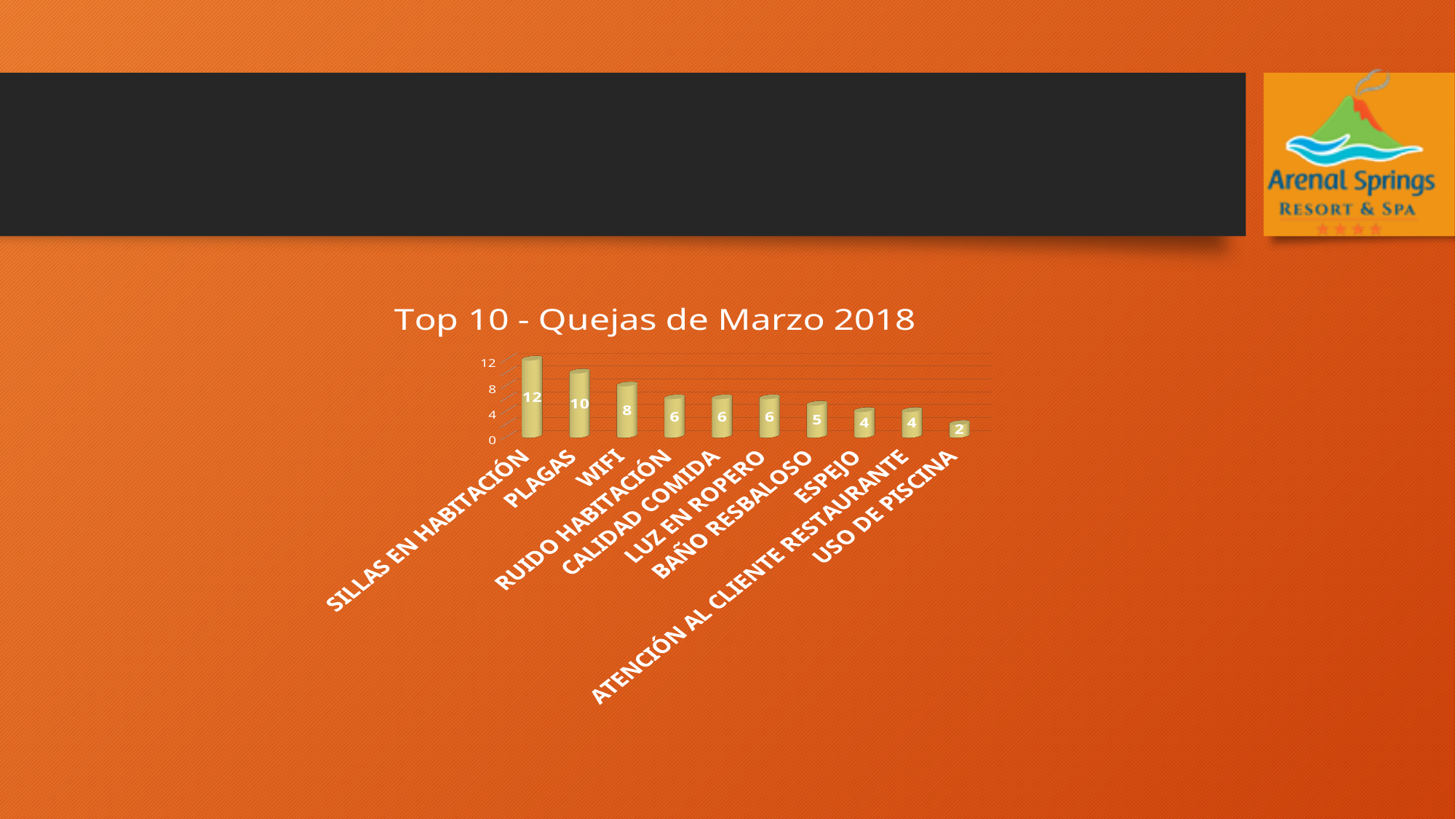
Which category has the highest value? SILLAS EN HABITACIÓN Do the values rise or fall from left to right along the x axis? Fall What is the value for SILLAS EN HABITACIÓN? 12 Which is larger, the value for BAÑO RESBALOSO or the value for ESPEJO? BAÑO RESBALOSO What is the value for WIFI? 8 Which category has the lowest value? USO DE PISCINA What is the value for USO DE PISCINA? 2 What is the value for PLAGAS? 10 What kind of chart is shown on the slide? Bar chart What is the title of the chart? Top 10 - Quejas de Marzo 2018 What is the difference between the values for SILLAS EN HABITACIÓN and PLAGAS? 2 How many categories are shown in the chart? 10